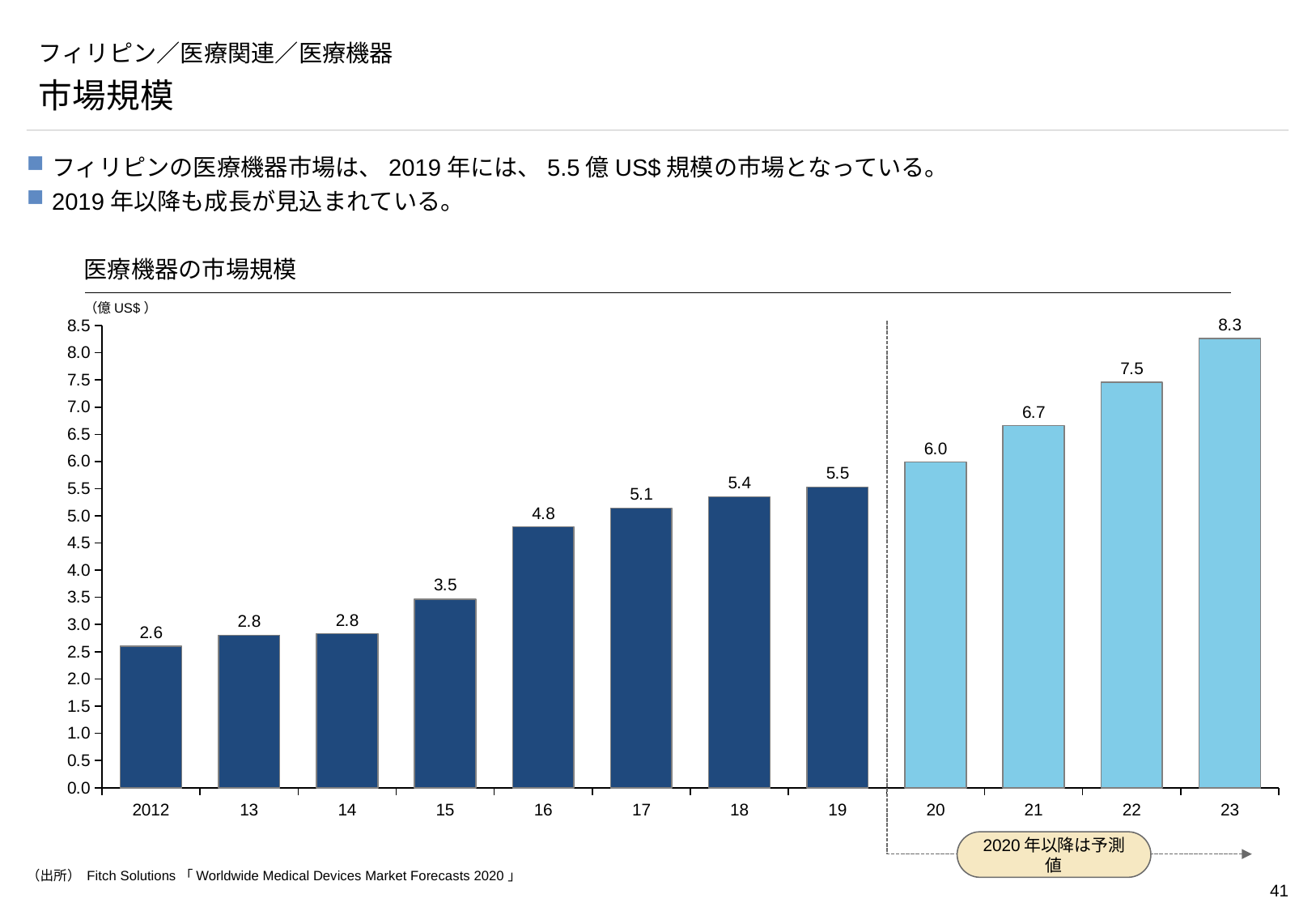
Which year has the highest value in the chart? 2023 What is the value for 2023 in the chart? 8.3 Which year has the lowest value in the chart? 2012 How many years (bars) are shown in the chart? 12 Which is larger, the value for 2020 or the value for 2019? 2020 What unit is shown on the chart's axis label? 億US$ Do the values generally rise or fall from 2012 to 2023? Rise What is the value for 2016 in the chart? 4.8 What kind of chart is shown on the slide? Bar chart What is the value for 2019 in the 医療機器の市場規模 chart? 5.5 What is the difference between the values for 2016 and 2015? 1.3 What is the difference between the values for 2023 and 2019? 2.8